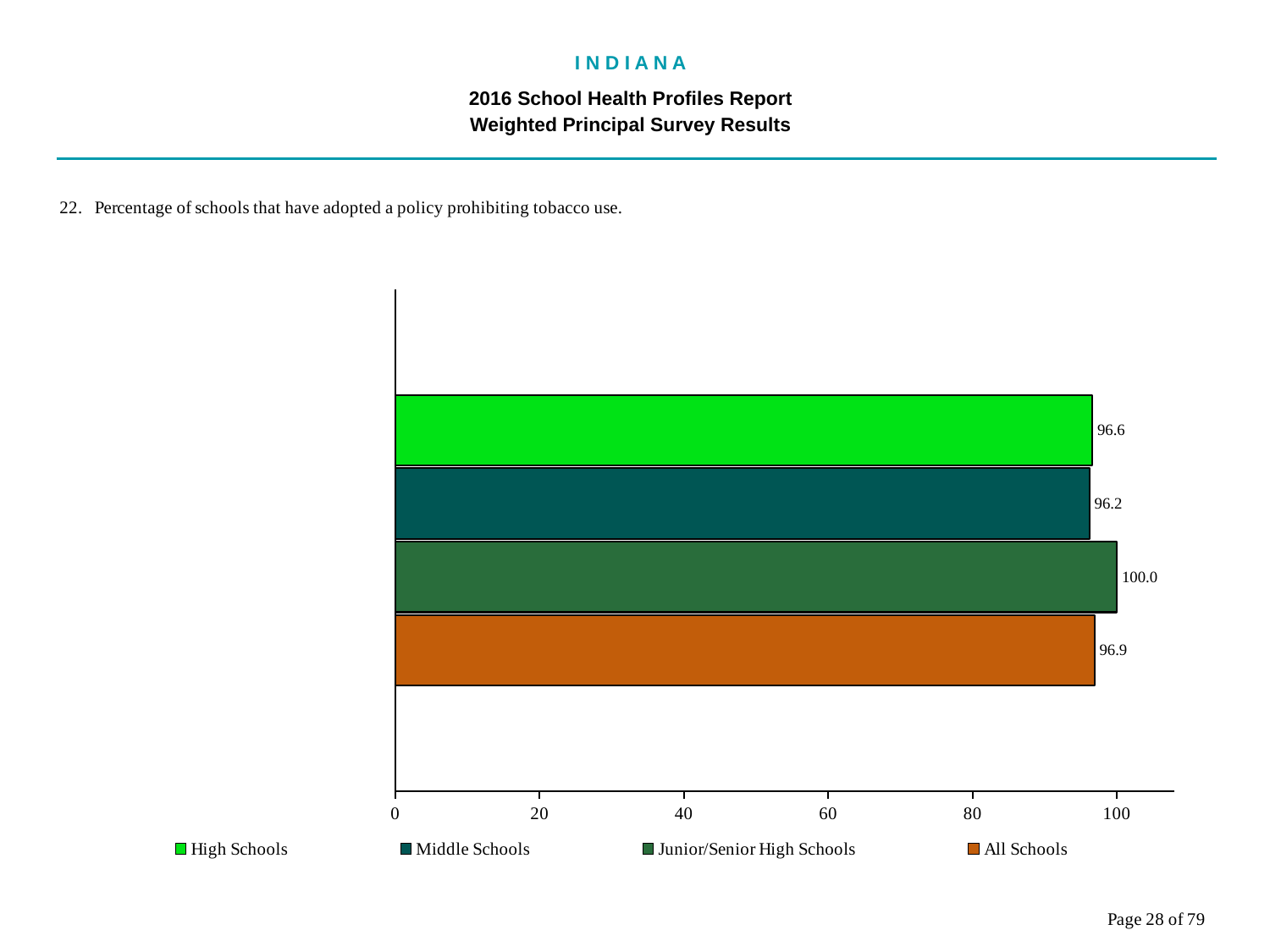
What kind of chart is shown on the slide? bar chart What is the value for Middle Schools? 96.2 Which school type has the lowest value? Middle Schools What is the value for High Schools? 96.6 What is the difference between the values for All Schools and High Schools? 0.3 Which school type has the highest value? Junior/Senior High Schools How many bars are shown in the chart? 4 What is the value for Junior/Senior High Schools? 100.0 Is the value for Middle Schools greater or less than 80? greater What is the value for All Schools? 96.9 What is the difference between the values for Junior/Senior High Schools and Middle Schools? 3.8 How many entries does the legend list? 4